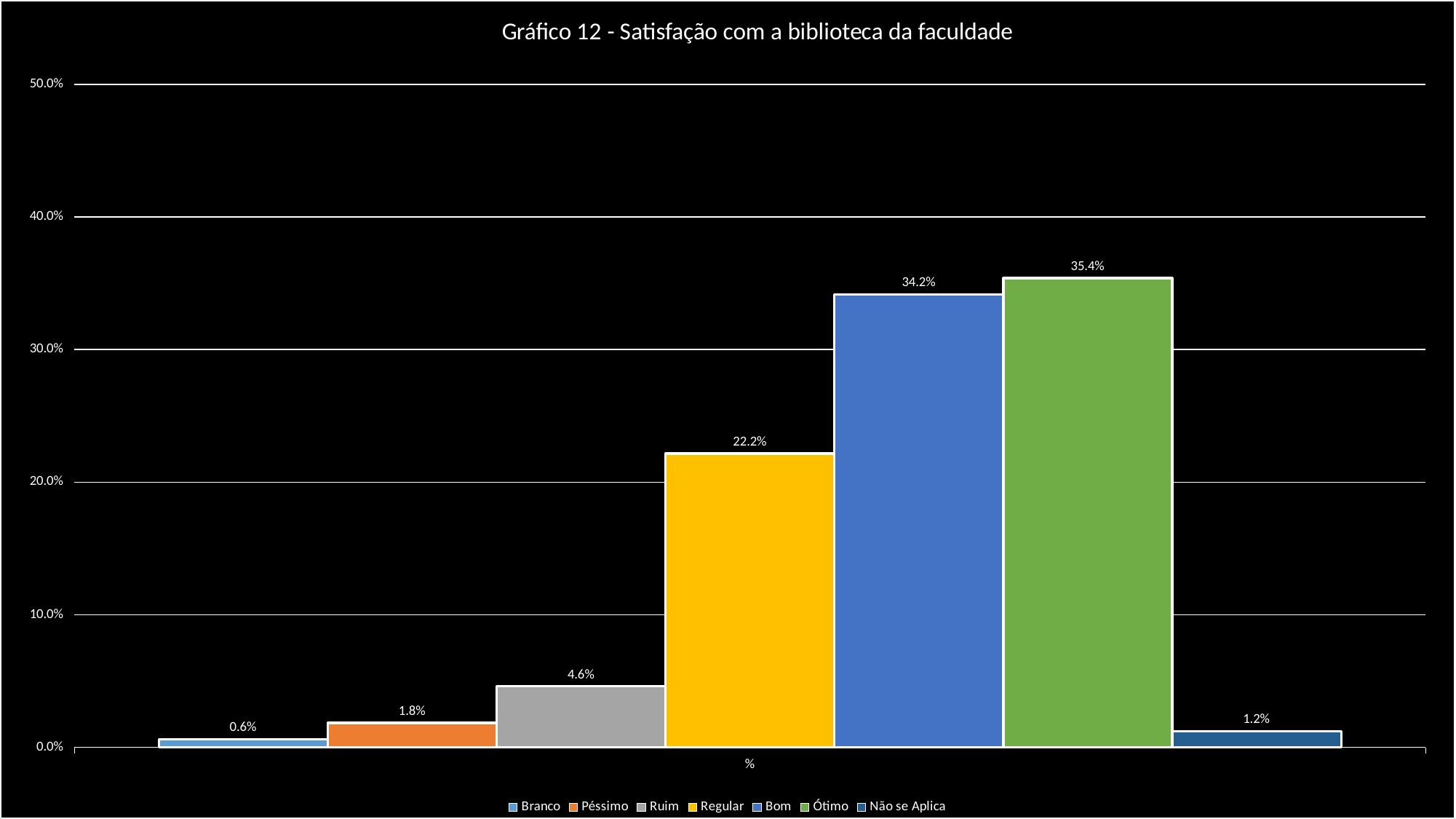
What kind of chart is shown? Bar chart What is the title of the chart? Gráfico 12 - Satisfação com a biblioteca da faculdade Which category has the highest value? Ótimo What is the difference between Bom and Regular? 12.0% What is the value for Ótimo? 35.4% Which is larger, Ruim or Péssimo? Ruim Which category has the lowest value? Branco What is the value for Regular? 22.2% Is the value for Bom greater or less than 30.0%? greater What is the value for Não se Aplica? 1.2% How many series does the legend list? 7 What is the value for Ruim? 4.6%